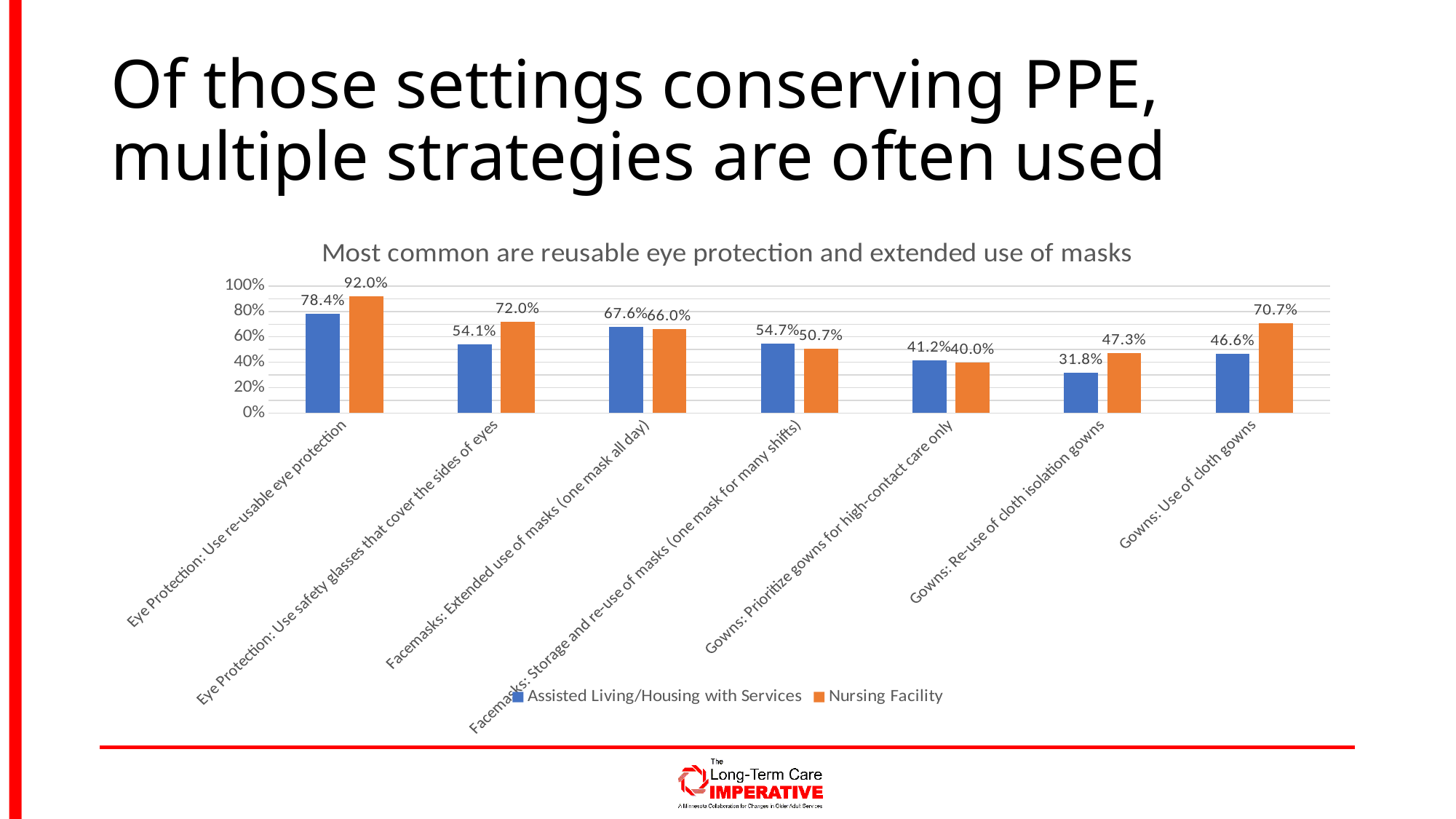
What is the Nursing Facility value for "Eye Protection: Use re-usable eye protection"? 92.0% What is the difference between the Nursing Facility and Assisted Living/Housing with Services values for "Gowns: Use of cloth gowns"? 24.1% For "Eye Protection: Use safety glasses that cover the sides of eyes", which series has the larger value? Nursing Facility Which category has the highest Nursing Facility value? Eye Protection: Use re-usable eye protection How many categories are shown on the x axis? 7 Which category has the lowest Assisted Living/Housing with Services value? Gowns: Re-use of cloth isolation gowns How many series does the legend list? 2 What is the Assisted Living/Housing with Services value for "Gowns: Re-use of cloth isolation gowns"? 31.8% Is the Assisted Living/Housing with Services value for "Gowns: Prioritize gowns for high-contact care only" greater or less than 60%? less What is the Nursing Facility value for "Gowns: Use of cloth gowns"? 70.7% What type of chart is shown on the slide? Bar chart What is the Assisted Living/Housing with Services value for "Facemasks: Extended use of masks (one mask all day)"? 67.6%